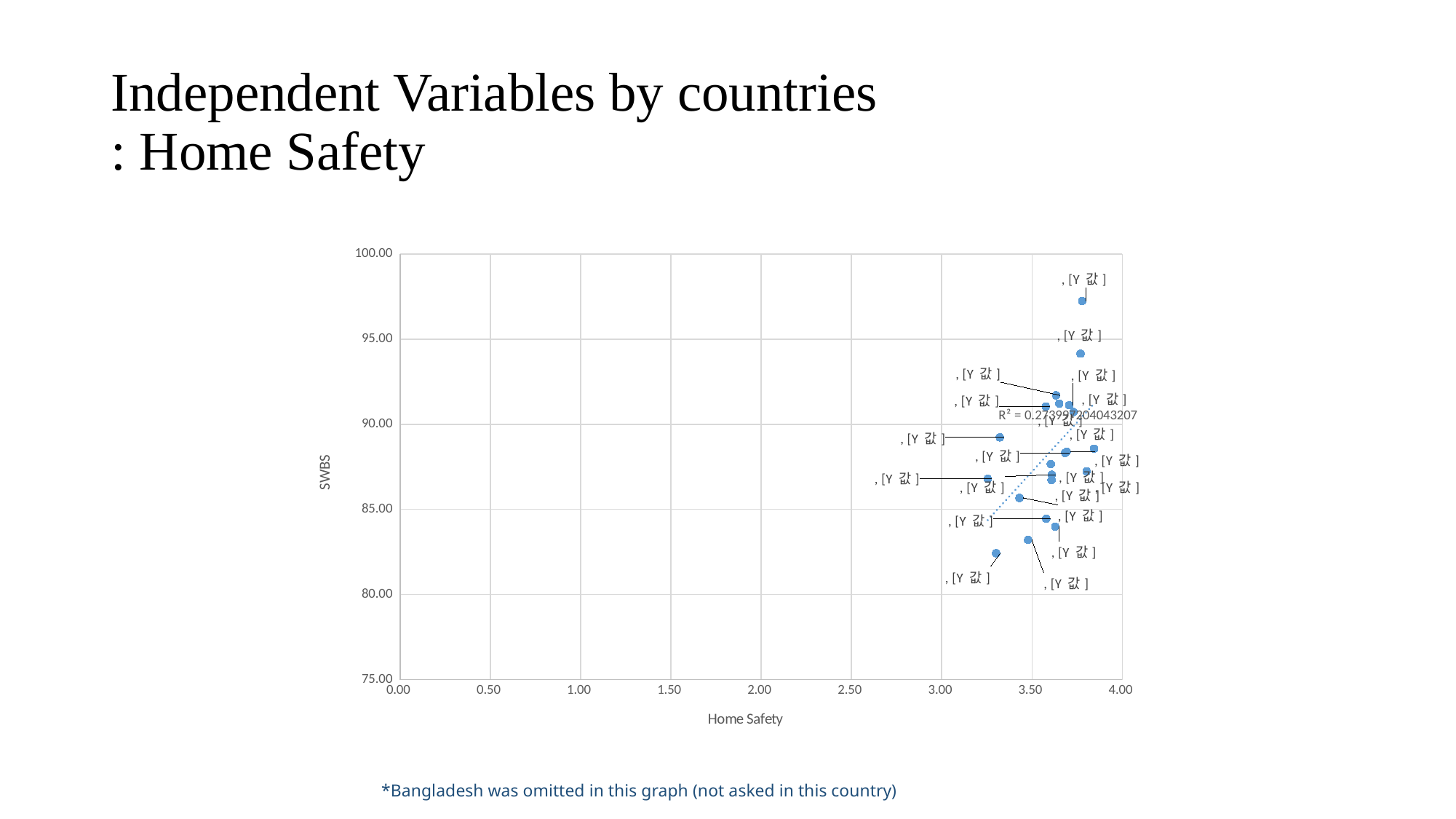
Is the lowest SWBS value plotted in the chart greater or less than 85.00? less What is the title of the y axis of the chart? SWBS What kind of chart is shown on the slide? scatter chart Is the lowest SWBS value plotted in the chart greater or less than 80.00? greater Is the highest SWBS value plotted in the chart greater or less than 100.00? less Does the dotted trendline in the chart rise or fall as Home Safety increases? rise What is the title of the x axis of the chart? Home Safety